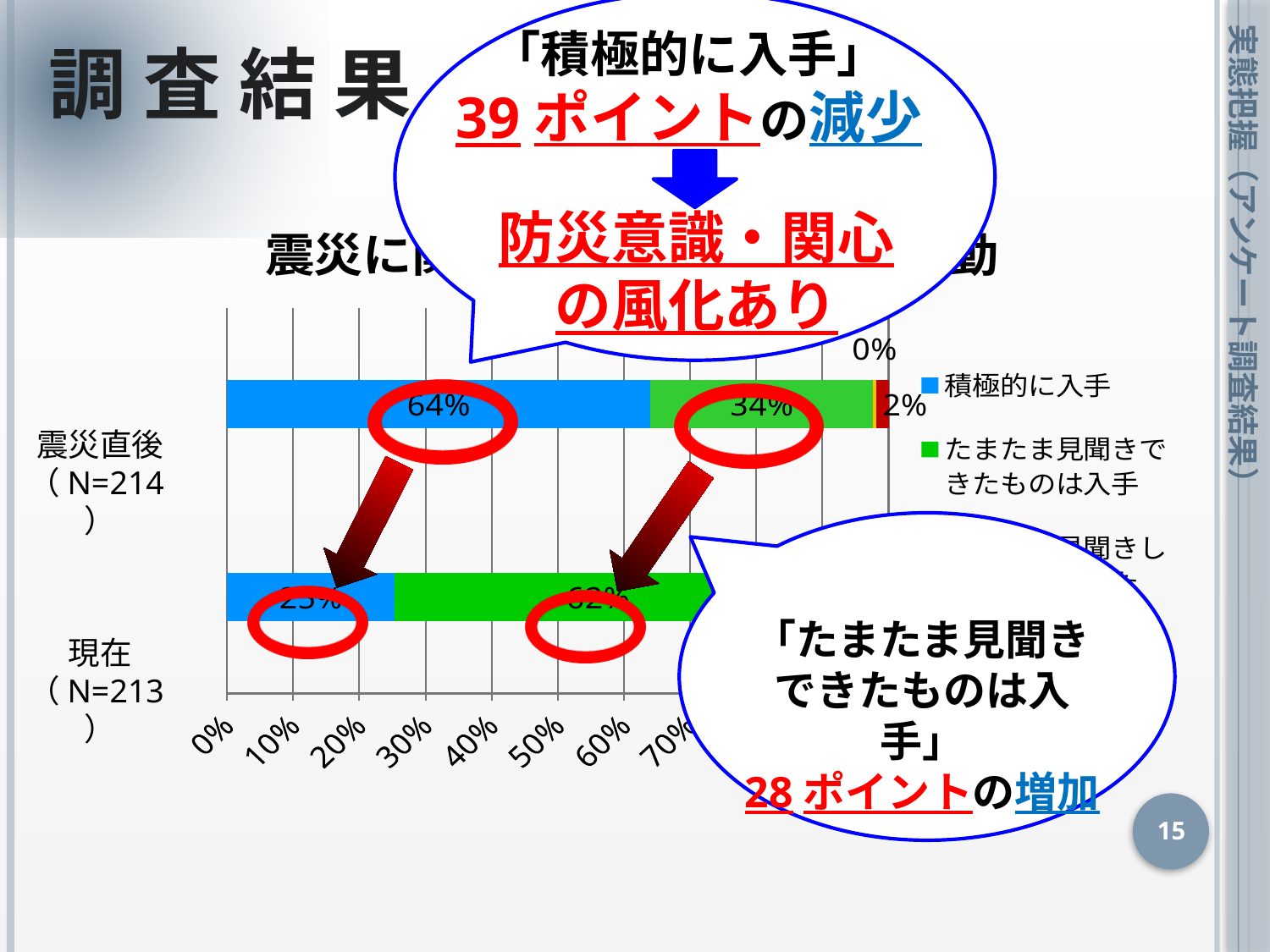
What percentage is shown for 積極的に入手 in the 現在 (N=213) bar? 25% Is the value for 積極的に入手 in the 現在 bar greater or less than 30%? less What kind of chart is shown on the slide? Stacked bar chart In the 震災直後 bar, how many percentage points larger is 積極的に入手 than たまたま見聞きできたものは入手? 30 percentage points What value is labelled on the red segment of the 震災直後 (N=214) bar? 2% Does the share of 積極的に入手 rise or fall from 震災直後 to 現在? fall In the 現在 bar, which is larger: 積極的に入手 or たまたま見聞きできたものは入手? たまたま見聞きできたものは入手 What percentage is shown for 積極的に入手 in the 震災直後 (N=214) bar? 64% What percentage is shown for たまたま見聞きできたものは入手 in the 震災直後 (N=214) bar? 34% How many bars (categories) does the chart show? 2 What colour represents 積極的に入手 in the legend? Blue In the 震災直後 bar, which is larger: 積極的に入手 or たまたま見聞きできたものは入手? 積極的に入手